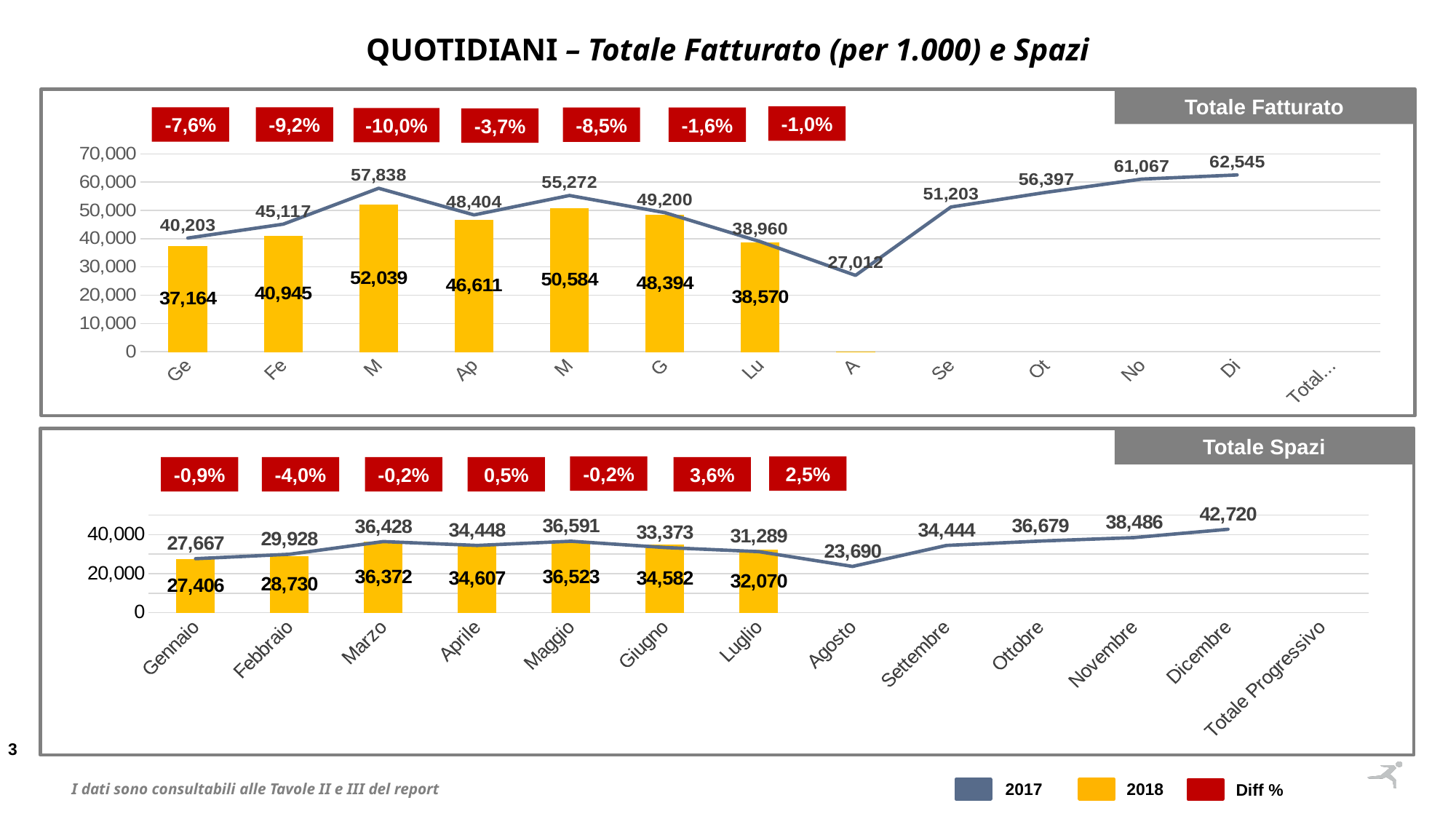
In the Totale Fatturato chart, what is the difference between the 2017 and 2018 values for Lu? 390 How many series does the legend at the bottom of the slide list? 3 In the Totale Fatturato chart, which month has the lowest 2017 value? A In the Totale Spazi chart, how many months have a 2018 bar? 7 In the Totale Spazi chart, which month has the highest 2017 value? Dicembre In the Totale Spazi chart, what is the 2018 value for Giugno? 34,582 In the Totale Fatturato chart, what is the 2017 value for Di? 62,545 In the Totale Fatturato chart, what is the 2018 value for Ge? 37,164 In the Totale Spazi chart, which is larger for Luglio, the 2017 value or the 2018 value? 2018 In the Totale Spazi chart, what is the Diff % shown for Giugno? 3,6% In the Totale Fatturato chart, what is the Diff % shown for Ap? -3,7% In the Totale Fatturato chart, what is the 2017 value for Ot? 56,397